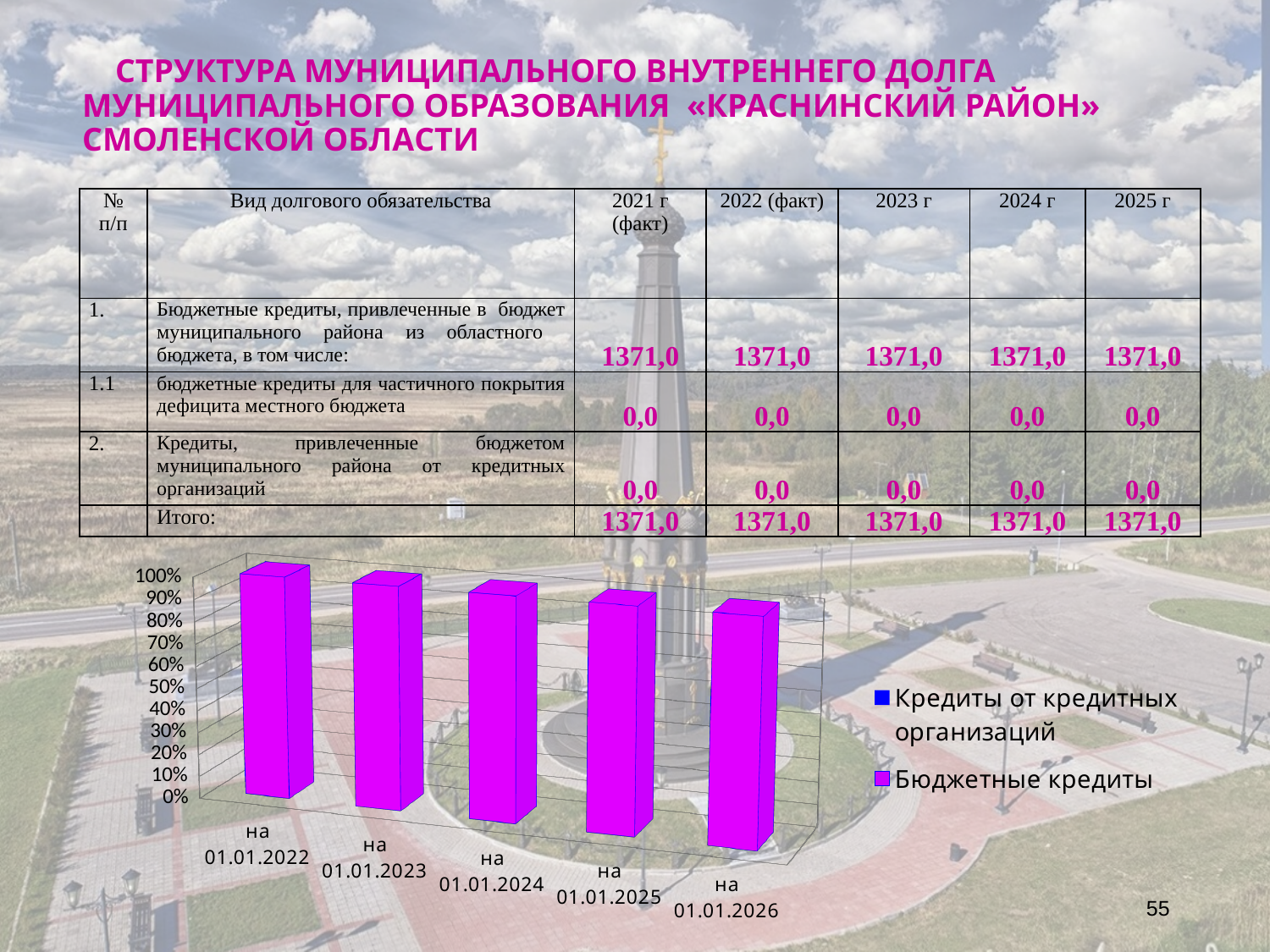
Which series is shown in magenta in the chart legend? Бюджетные кредиты What is the last category label on the x axis of the chart? на 01.01.2026 How many categories (dates) are shown on the x axis of the chart? 5 Is the value of the bar for на 01.01.2024 greater or less than 50%? greater Which series is shown in blue in the chart legend? Кредиты от кредитных организаций What is the first category label on the x axis of the chart? на 01.01.2022 How many series does the chart legend list? 2 Is the value of the bar for на 01.01.2026 greater or less than 30%? greater What is the highest tick value shown on the y axis of the chart? 100% Is the value of the bar for на 01.01.2022 greater or less than 50%? greater What kind of chart is shown on the slide? bar chart